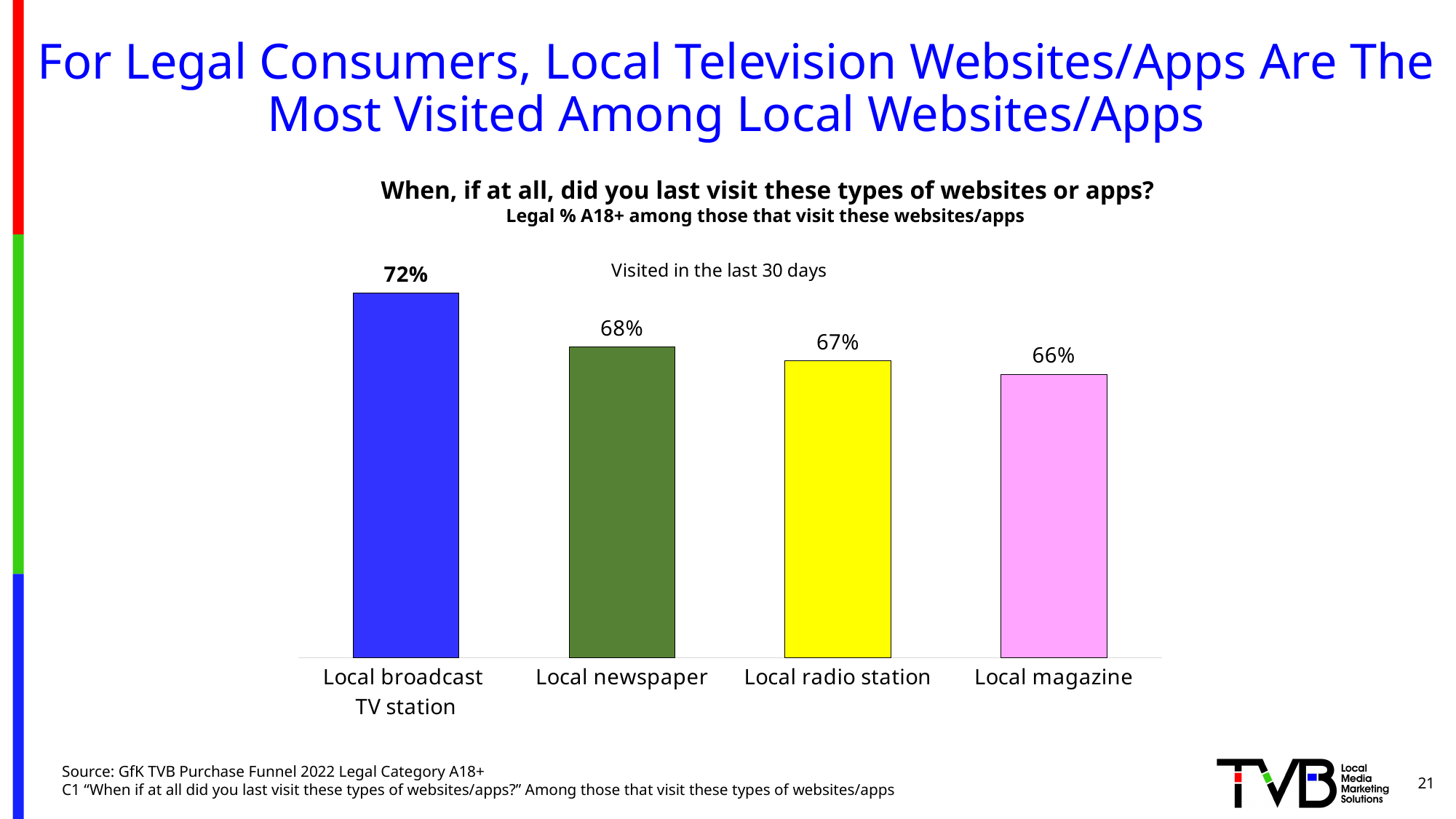
What is the value shown for Local radio station? 67% What percentage of legal consumers visited a local broadcast TV station website/app in the last 30 days? 72% Which category has the lowest value? Local magazine What kind of chart is shown on the slide? Bar chart Which category has the highest value? Local broadcast TV station What is the value shown for Local magazine? 66% What label appears above the bars describing the time period measured? Visited in the last 30 days How many categories are shown in the chart? 4 What is the difference in percentage points between Local newspaper and Local radio station? 1 percentage point What is the difference in percentage points between Local broadcast TV station and Local magazine? 6 percentage points Do the values rise or fall moving from left to right across the categories? Fall What is the value shown for Local newspaper? 68%